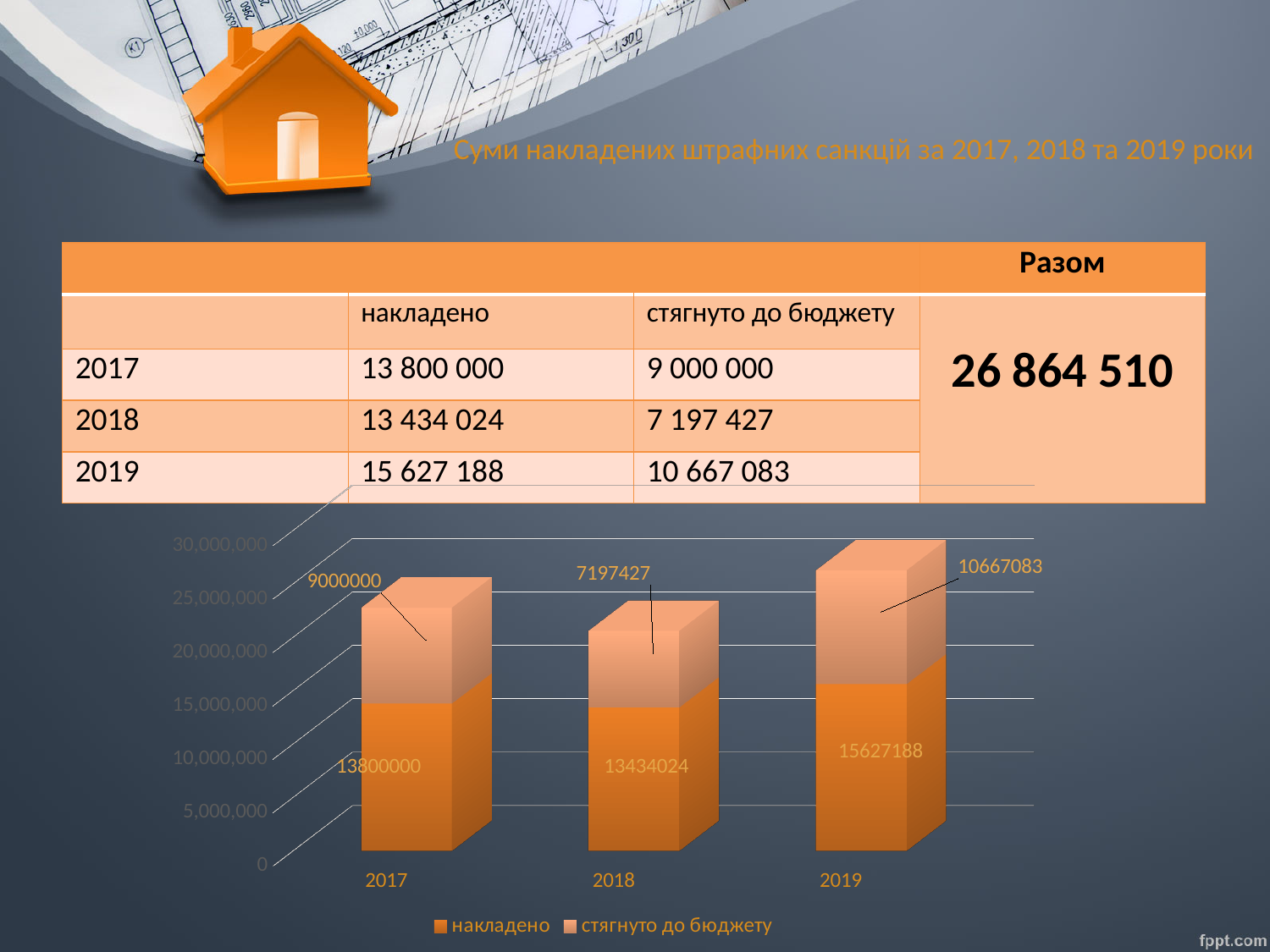
What is the difference between the накладено values for 2019 and 2017? 1827188 Which is larger: стягнуто до бюджету for 2017 or for 2018? 2017 What is the value of стягнуто до бюджету for 2018 in the chart? 7197427 What is the value of накладено for 2017 in the chart? 13800000 How many years are shown on the x axis of the chart? 3 What is the total of the stacked bar for 2019? 26294271 How many series does the chart legend list? 2 What kind of chart is shown on the slide? Stacked bar chart Which year has the highest накладено value in the chart? 2019 What are the two series named in the chart legend? накладено and стягнуто до бюджету Which year has the lowest стягнуто до бюджету value in the chart? 2018 What is the value of стягнуто до бюджету for 2019 in the chart? 10667083